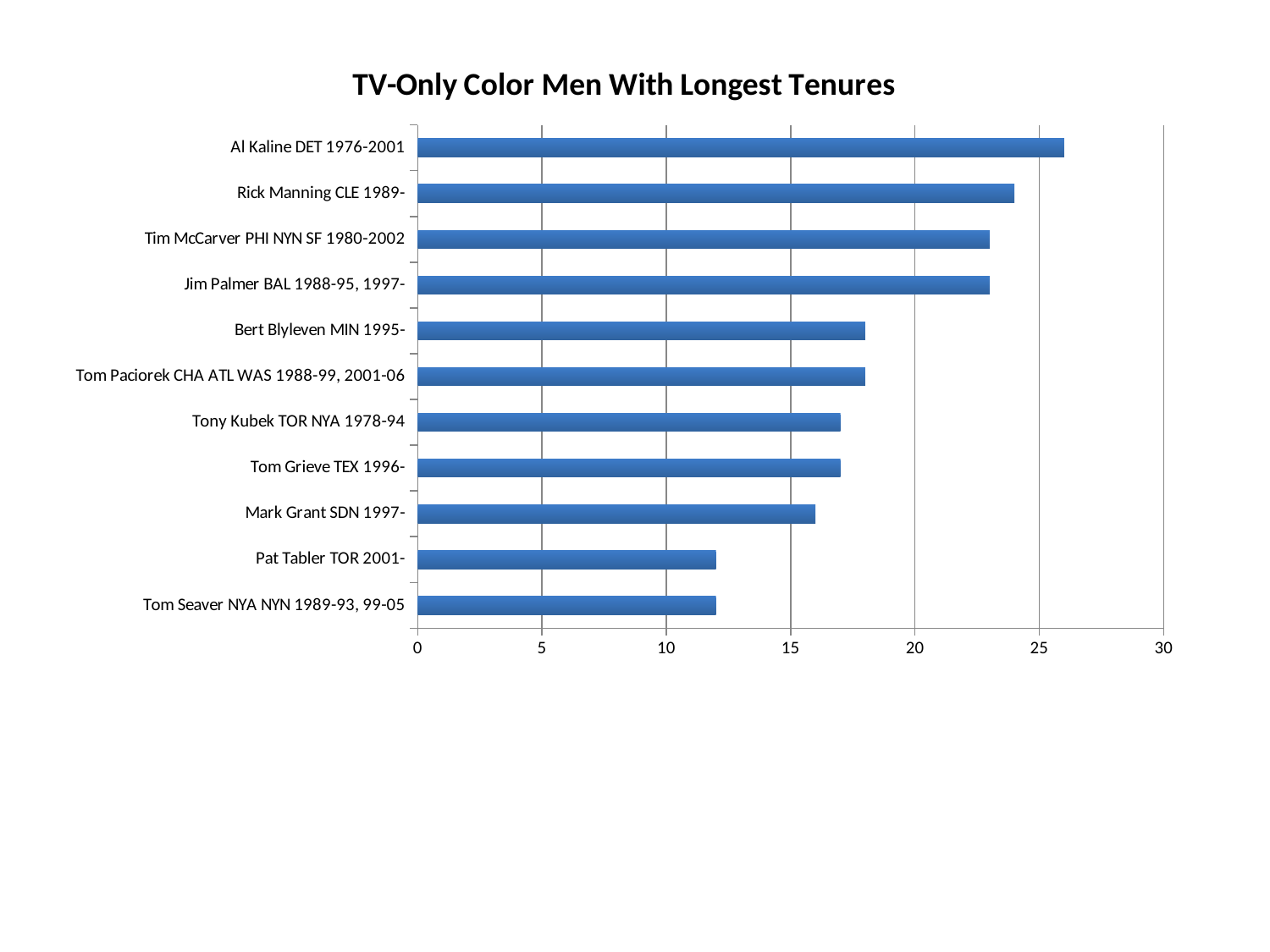
Is the value for Mark Grant SDN 1997- greater or less than 15? greater Which color man has the longest tenure in the chart? Al Kaline DET 1976-2001 Is the value for Rick Manning CLE 1989- greater or less than 25? less Which is larger, the value for Bert Blyleven MIN 1995- or the value for Mark Grant SDN 1997-? Bert Blyleven MIN 1995- Which is larger, the value for Al Kaline DET 1976-2001 or the value for Rick Manning CLE 1989-? Al Kaline DET 1976-2001 Is the value for Al Kaline DET 1976-2001 greater or less than 25? greater How many color men (categories) are shown in the chart? 11 What is the title of the chart? TV-Only Color Men With Longest Tenures What type of chart is shown on the slide? bar chart